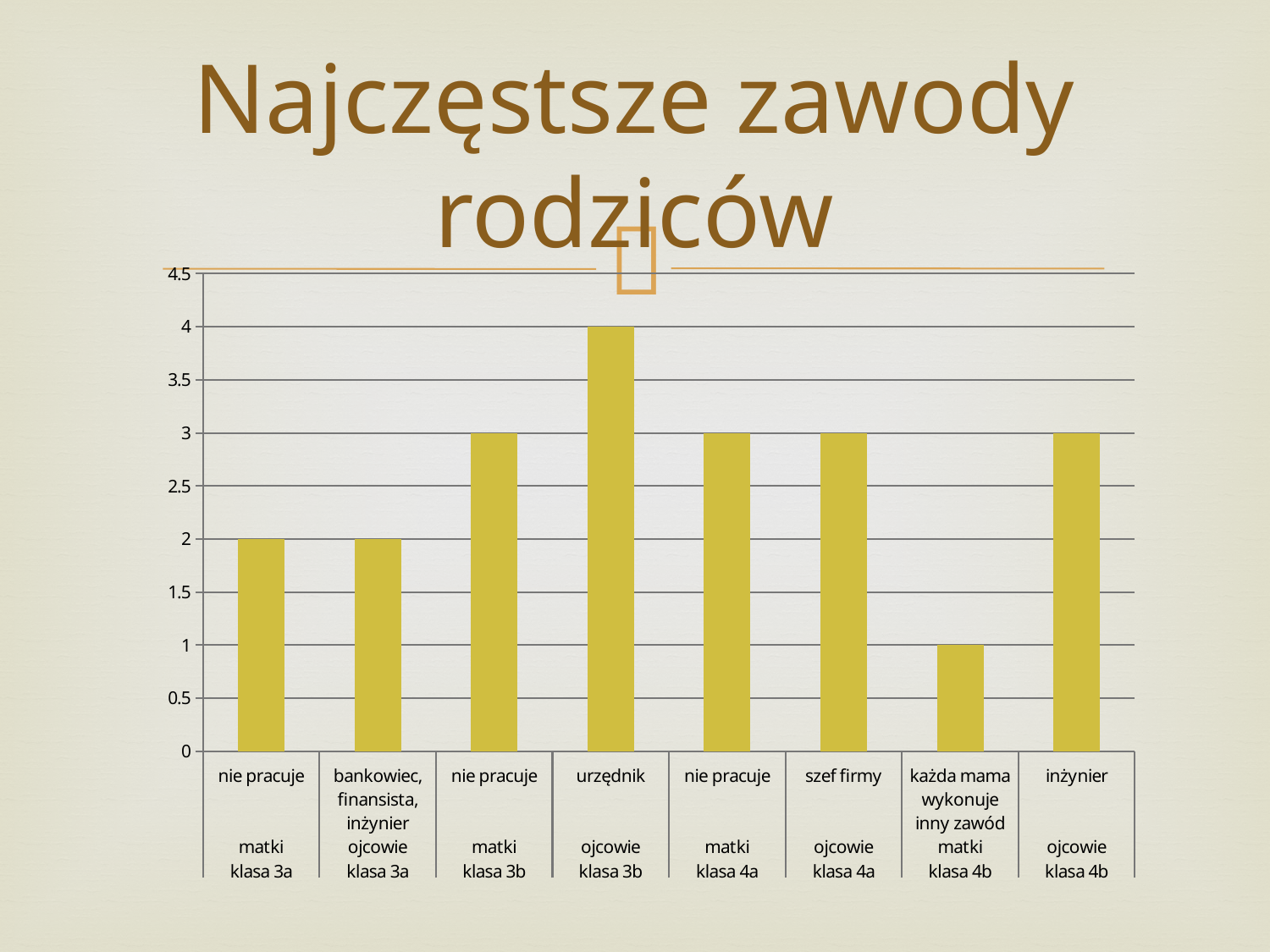
What is the title of the chart on the slide? Najczęstsze zawody rodziców What is the value for "szef firmy" (ojcowie klasa 4a)? 3 Which category has the highest value? urzędnik (ojcowie klasa 3b) Is the value for "inżynier" (ojcowie klasa 4b) greater or less than 2? greater Which is larger: the value for "nie pracuje" (matki klasa 3b) or the value for "nie pracuje" (matki klasa 3a)? nie pracuje (matki klasa 3b) What is the difference between the value for "urzędnik" (ojcowie klasa 3b) and the value for "bankowiec, finansista, inżynier" (ojcowie klasa 3a)? 2 What type of chart is shown on the slide? bar chart What is the value for "każda mama wykonuje inny zawód" (matki klasa 4b)? 1 Which category has the lowest value? każda mama wykonuje inny zawód (matki klasa 4b) What is the value for "urzędnik" (ojcowie klasa 3b)? 4 What is the value for "nie pracuje" (matki klasa 3a)? 2 How many bars are plotted in the chart? 8